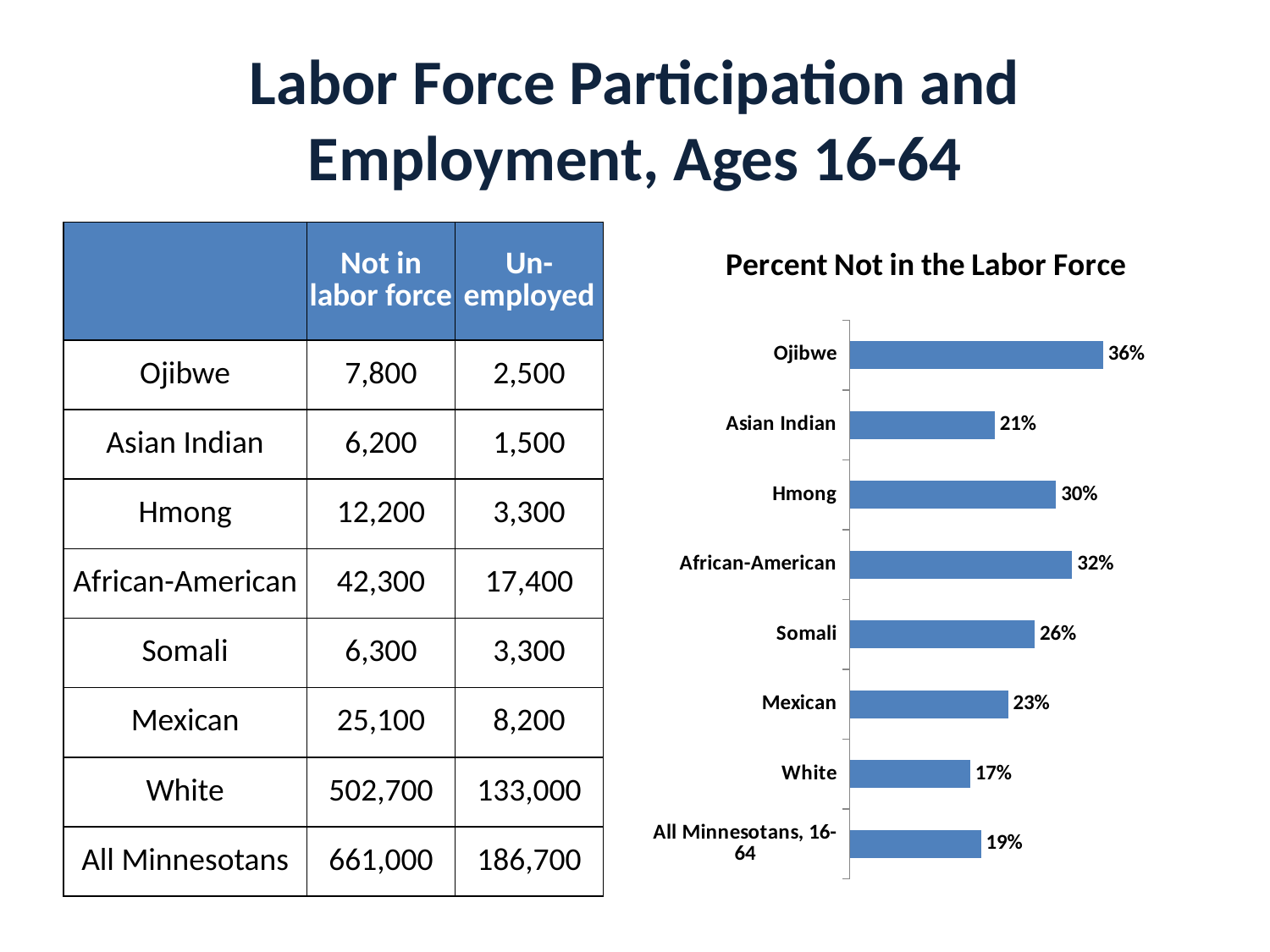
Which group has the highest percent not in the labor force? Ojibwe Which has a higher percent not in the labor force, Mexican or Asian Indian? Mexican How many groups are shown in the chart? 8 What is the difference in percent not in the labor force between Ojibwe and White? 19% Which group has the lowest percent not in the labor force? White What is the percent not in the labor force for All Minnesotans, 16-64? 19% Which has a higher percent not in the labor force, Hmong or Somali? Hmong What is the percent not in the labor force for Ojibwe? 36% What kind of chart is shown on the slide? Bar chart What is the title of the chart? Percent Not in the Labor Force What is the percent not in the labor force for Hmong? 30% What is the difference in percent not in the labor force between African-American and Somali? 6%